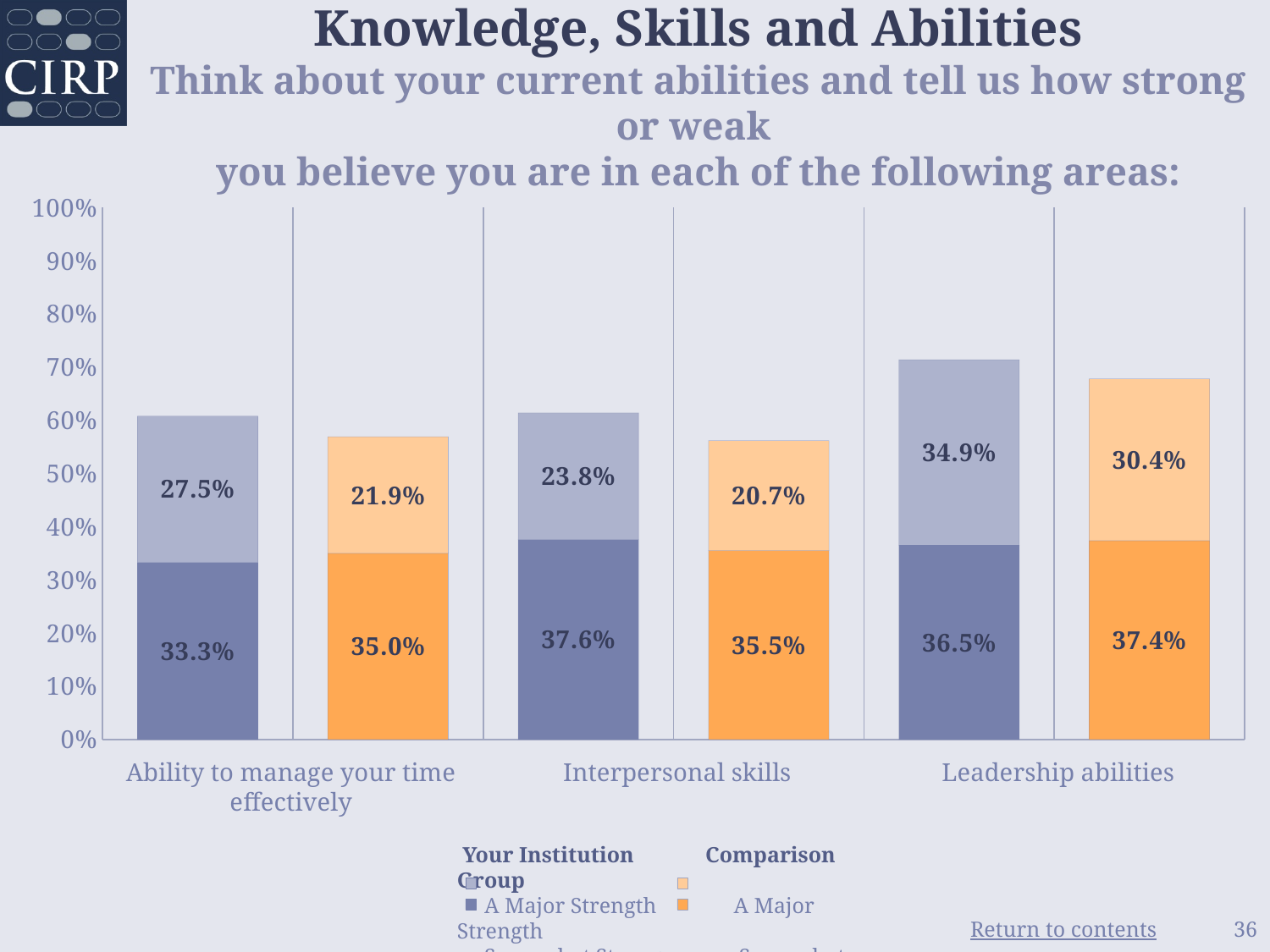
Is the total of the Comparison Group stacked bar for Interpersonal skills greater or less than 60%? less Which category has the highest 'A Major Strength' value for Your Institution? Interpersonal skills What is the value of the upper (lighter) segment of the Comparison Group bar for Ability to manage your time effectively? 21.9% What kind of chart is shown on the slide? bar chart What is the value of the upper (lighter) segment of the Your Institution bar for Leadership abilities? 34.9% What is the difference between the 'A Major Strength' values for Your Institution and the Comparison Group for Ability to manage your time effectively? 1.7% What is the 'A Major Strength' value for the Comparison Group for Leadership abilities? 37.4% Which category has the lowest upper (lighter) segment value for the Comparison Group? Interpersonal skills What is the total of the Your Institution stacked bar for Leadership abilities? 71.4% Which is larger for Leadership abilities: the 'A Major Strength' value for Your Institution or for the Comparison Group? Comparison Group What is the 'A Major Strength' value for Your Institution for Interpersonal skills? 37.6% How many categories are shown on the x axis? 3